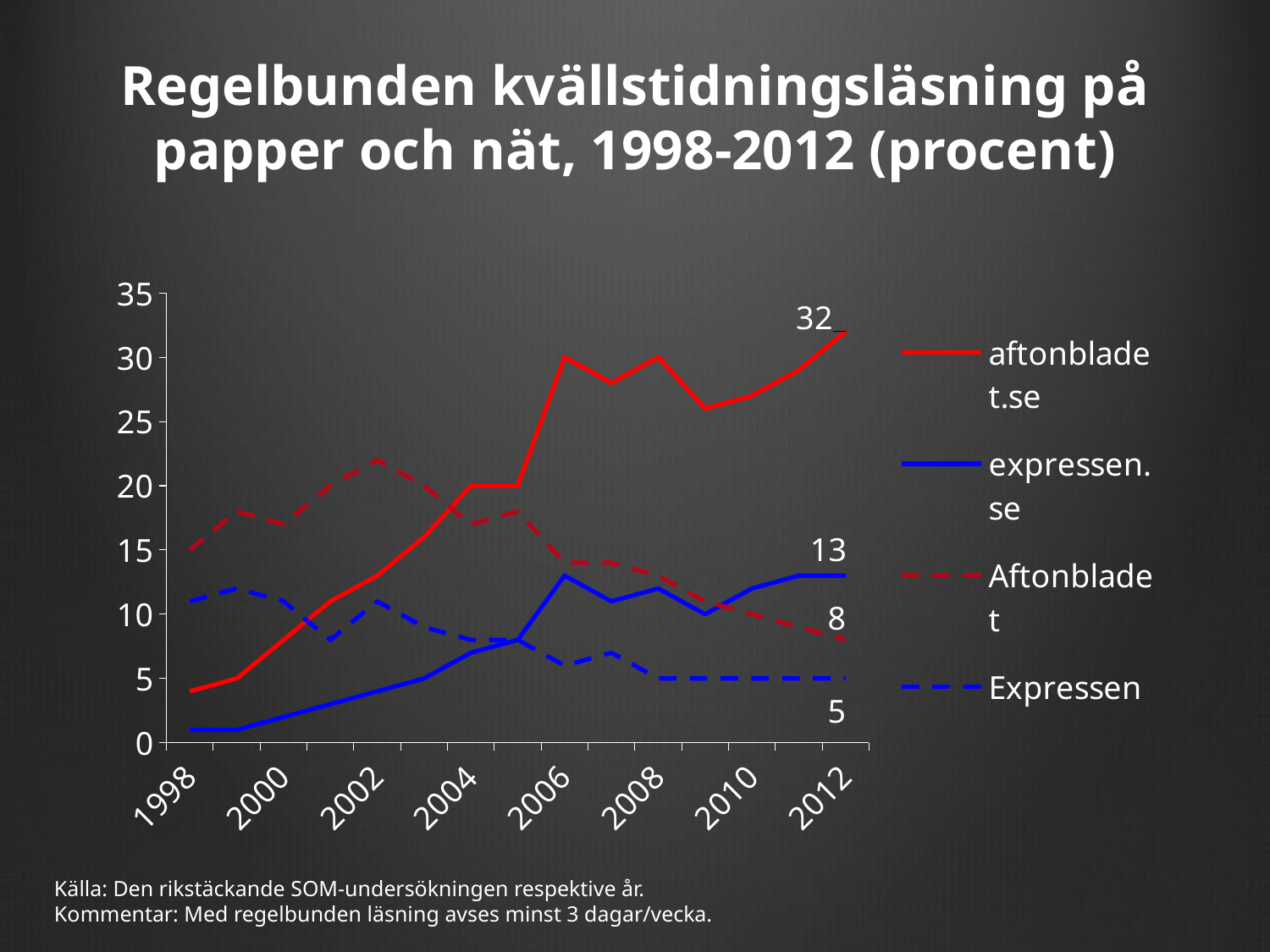
Which is larger in 2012, aftonbladet.se or Aftonbladet? aftonbladet.se Which series has the highest value in 2012? aftonbladet.se What is the difference between aftonbladet.se and expressen.se in 2012? 19 What is the value for expressen.se in 2012? 13 Is the value for Aftonbladet in 2002 greater or less than 20? greater What is the value for Aftonbladet (paper) in 2012? 8 Which series has the lowest value in 2012? Expressen Does the aftonbladet.se series generally rise or fall from 1998 to 2012? rise How many series does the legend list? 4 What is the value for aftonbladet.se in 2012? 32 What is the value for Expressen (paper) in 2012? 5 What kind of chart is shown on the slide? line chart